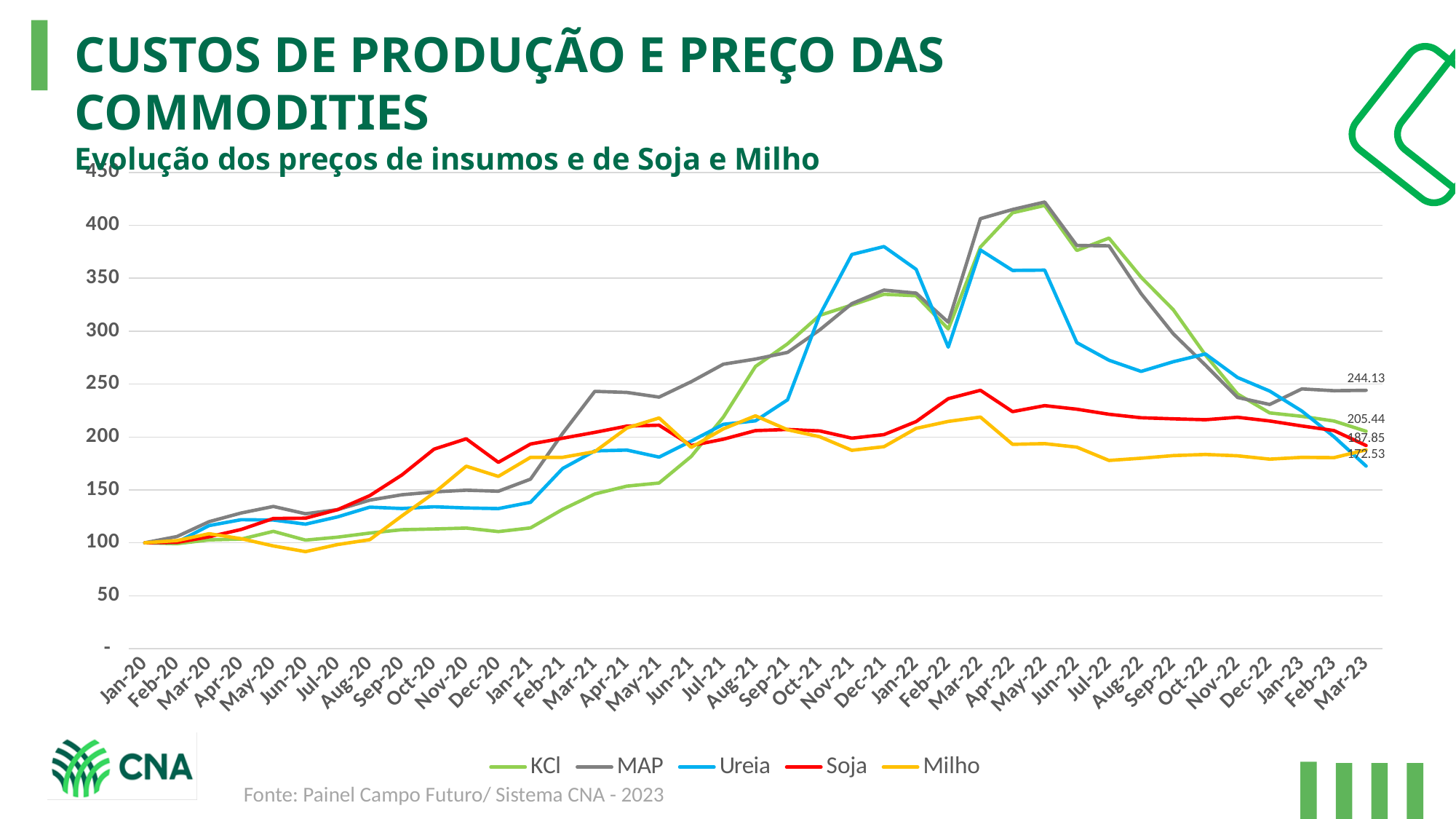
How many series does the legend list? 5 How many months are shown on the x axis? 39 Is the value for Milho at Jun-20 greater or less than 100? less Which series has the lowest value at Mar-23? Ureia What is the subtitle of the chart? Evolução dos preços de insumos e de Soja e Milho Which series has the highest value at Mar-23? MAP What kind of chart is shown on the slide? line chart What is the value of KCl at Mar-23? 205.44 What is the value of Ureia at Mar-23? 172.53 What is the value of MAP at Mar-23? 244.13 Is the value for MAP at Apr-22 greater or less than 400? greater What is the difference between MAP and KCl at Mar-23? 38.69